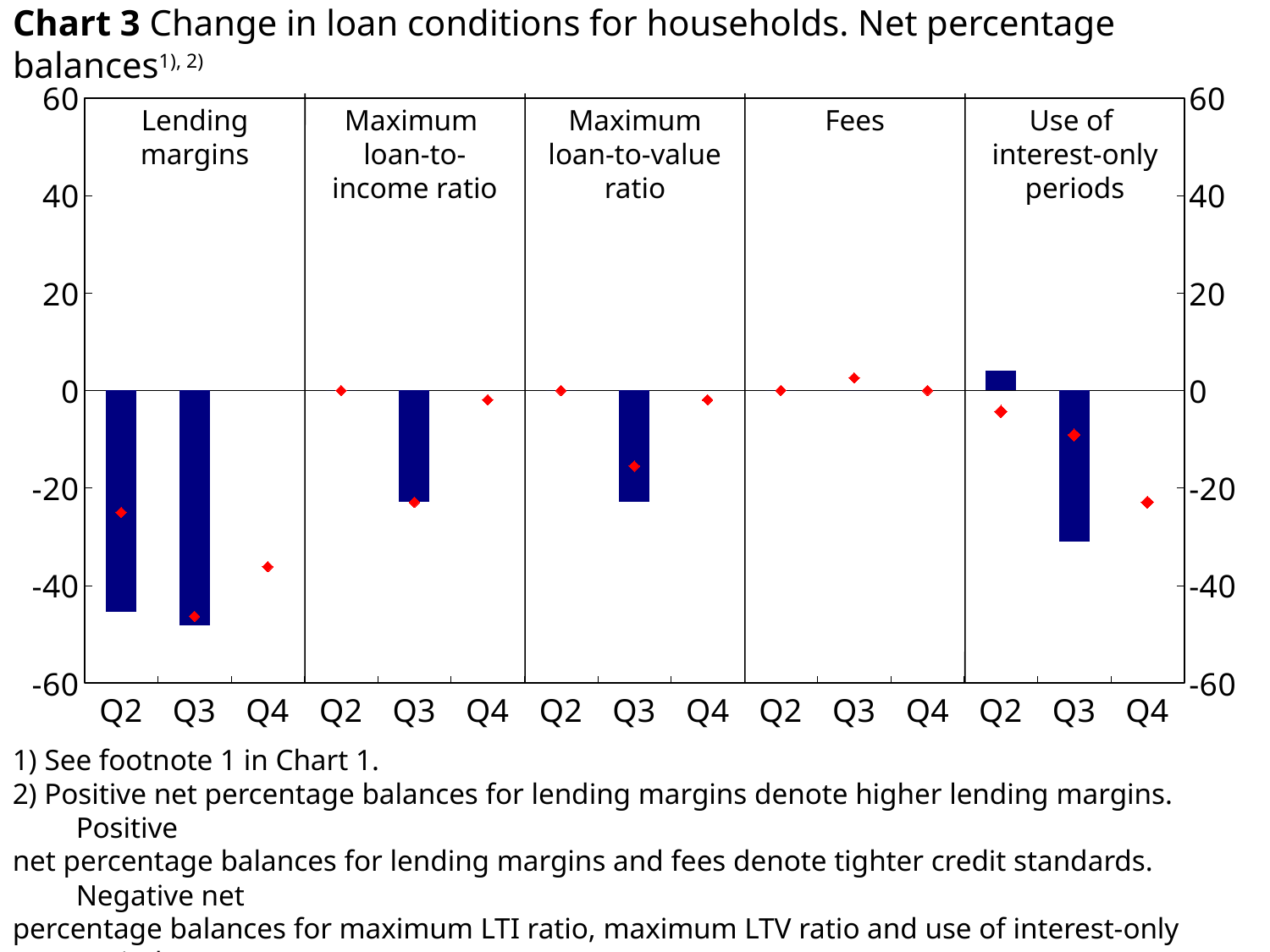
What kind of chart is shown on the slide? bar chart What is the title of the chart? Chart 3 Change in loan conditions for households. Net percentage balances Is the Q2 bar for Lending margins greater or less than -40? less Which is lower: the Q2 bar for Lending margins or the Q3 bar for Use of interest-only periods? Q2 bar for Lending margins How many quarters are shown in each panel of the chart? 3 Which panel contains the lowest bar in the chart? Lending margins Is the Q3 bar for Maximum loan-to-income ratio greater or less than -40? greater Which panel of the chart shows no bars at all? Fees Is the Q3 bar for Use of interest-only periods greater or less than -20? less How many loan condition panels does the chart show? 5 Which panel of the chart contains a bar above zero? Use of interest-only periods